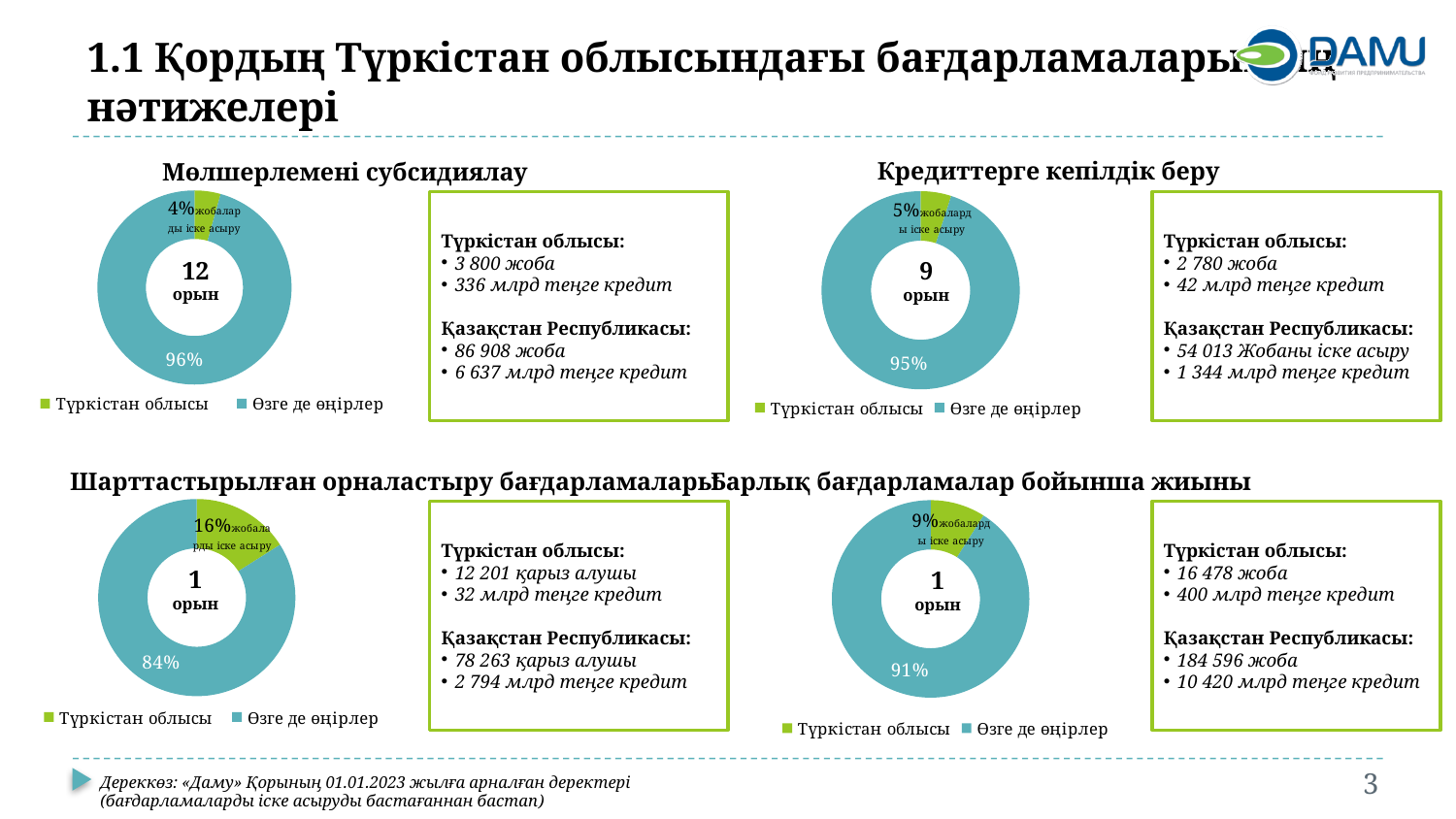
In the 'Шарттастырылған орналастыру бағдарламалары' chart, what is the difference between the Өзге де өңірлер share and the Түркістан облысы share? 68% In the 'Кредиттерге кепілдік беру' chart, what share is shown for Өзге де өңірлер? 95% In the 'Барлық бағдарламалар бойынша жиыны' chart, what share is shown for Өзге де өңірлер? 91% How many entries does the legend of the 'Шарттастырылған орналастыру бағдарламалары' chart list? 2 How many slices does the 'Мөлшерлемені субсидиялау' chart have? 2 In the 'Мөлшерлемені субсидиялау' chart, what share is shown for Өзге де өңірлер? 96% What kind of chart is used for 'Кредиттерге кепілдік беру'? Pie (donut) chart What number is printed in the centre of the 'Мөлшерлемені субсидиялау' chart? 12 орын In the 'Барлық бағдарламалар бойынша жиыны' chart, which slice is larger, Түркістан облысы or Өзге де өңірлер? Өзге де өңірлер